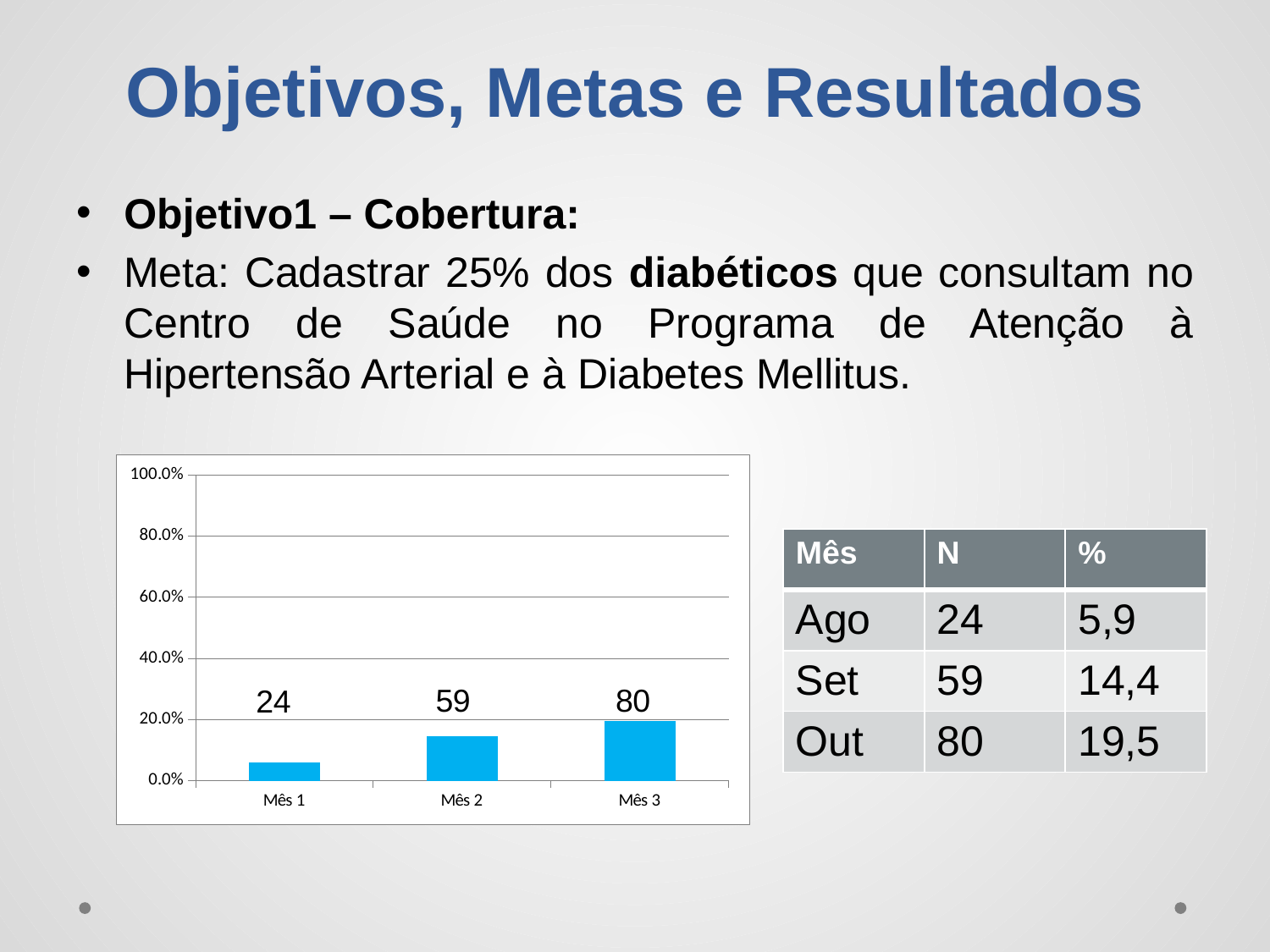
Which bar is taller, Mês 2 or Mês 3? Mês 3 What is the data label shown above the bar for Mês 2? 59 What is the difference between the data labels for Mês 3 and Mês 1? 56 What type of chart is shown on the slide? bar chart What is the data label shown above the bar for Mês 3? 80 Do the bar heights rise or fall from Mês 1 to Mês 3? rise What is the data label shown above the bar for Mês 1? 24 How many bars are plotted in the chart? 3 What is the difference between the data labels for Mês 2 and Mês 1? 35 Which month has the shortest bar in the chart? Mês 1 Which month has the tallest bar in the chart? Mês 3